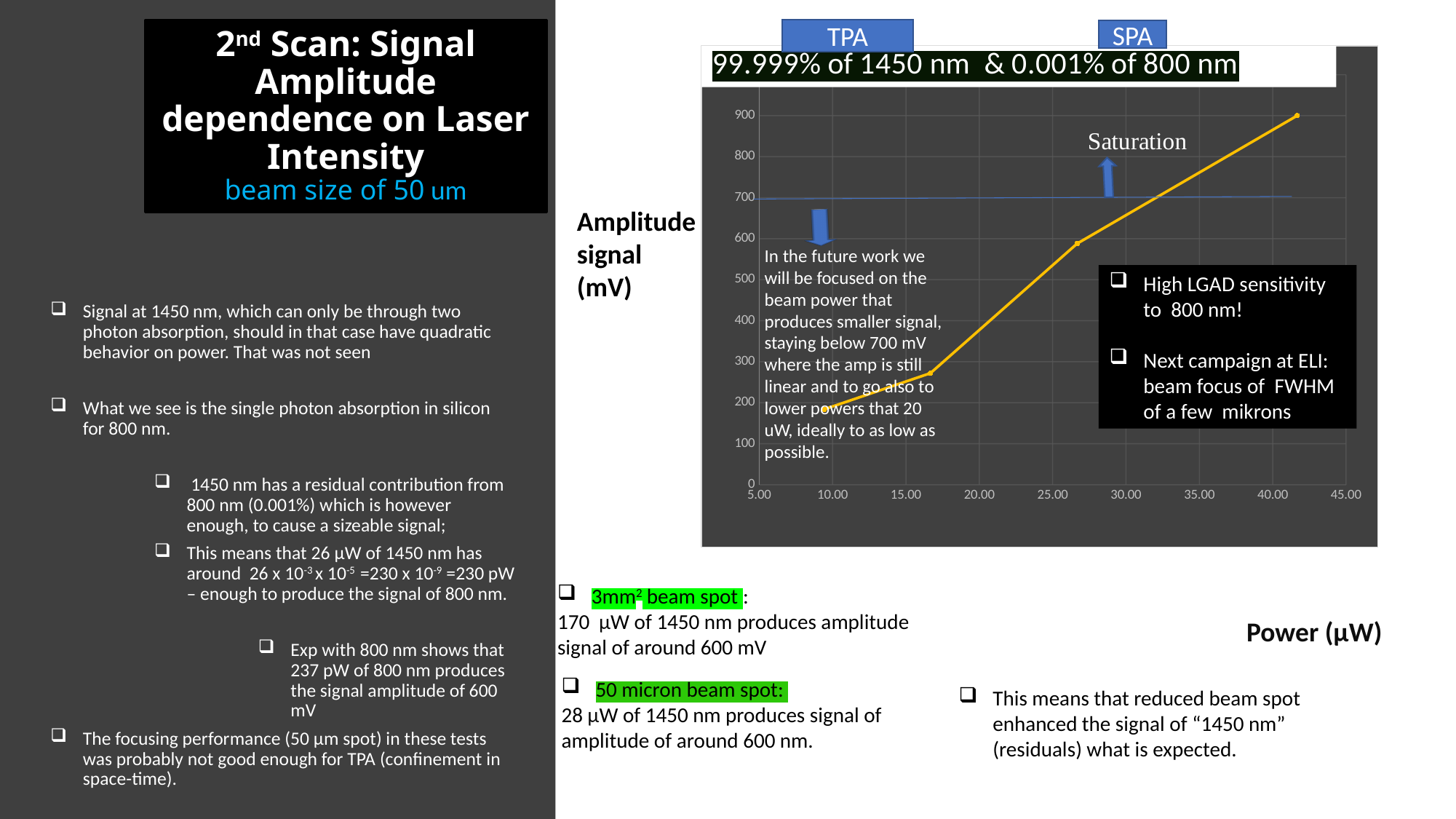
What is the label of the x axis of the chart? Power (µW) What kind of chart is shown on the slide? line chart Is the amplitude signal at the third data point (around 26 µW) greater or less than 700 mV? less What is the highest value shown on the y axis of the chart? 900 Is the amplitude signal at the highest plotted power (around 41 µW) greater or less than 800 mV? greater Which plotted point has the highest amplitude signal: the one at about 26 µW or the one at about 41 µW? the one at about 41 µW Does the orange amplitude signal line rise or fall as power increases along the x axis? rise At what amplitude value is the horizontal blue 'Saturation' line drawn? 700 Is the amplitude signal at the lowest plotted power (around 9 µW) greater or less than 300 mV? less What is the title printed above the chart? 99.999% of 1450 nm & 0.001% of 800 nm How many data points are plotted on the orange line? 4